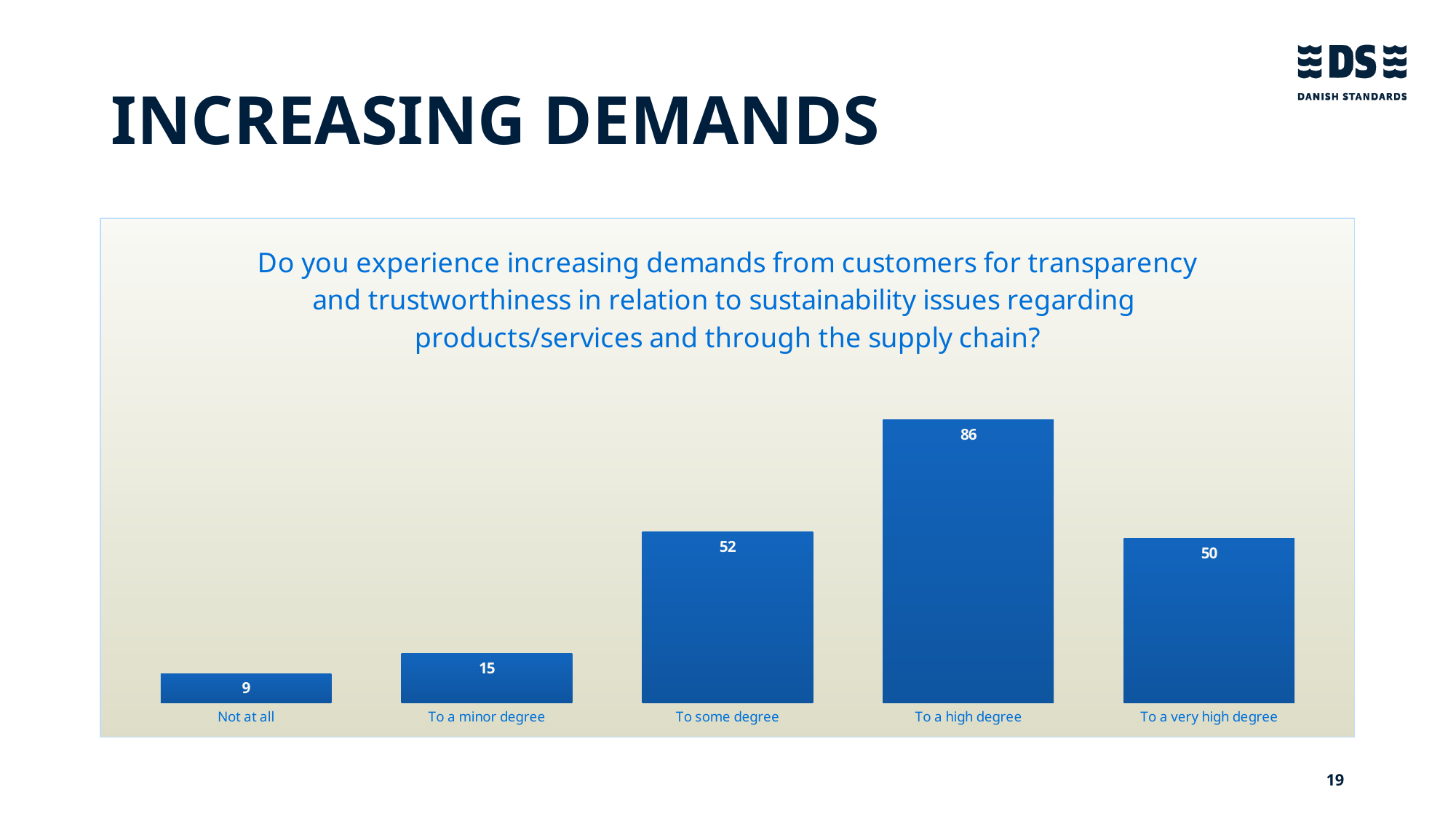
What question does the chart title ask? Do you experience increasing demands from customers for transparency and trustworthiness in relation to sustainability issues regarding products/services and through the supply chain? Which is larger, the value for "To some degree" or the value for "To a very high degree"? To some degree What is the value for "To a very high degree"? 50 What is the difference between the values for "To a minor degree" and "Not at all"? 6 What kind of chart is shown on the slide? Bar chart What is the value for "To a high degree"? 86 What is the value for "To some degree"? 52 What is the value for "Not at all"? 9 Which category has the lowest value? Not at all What is the difference between the values for "To a high degree" and "To some degree"? 34 How many categories are shown in the chart? 5 Which category has the highest value? To a high degree